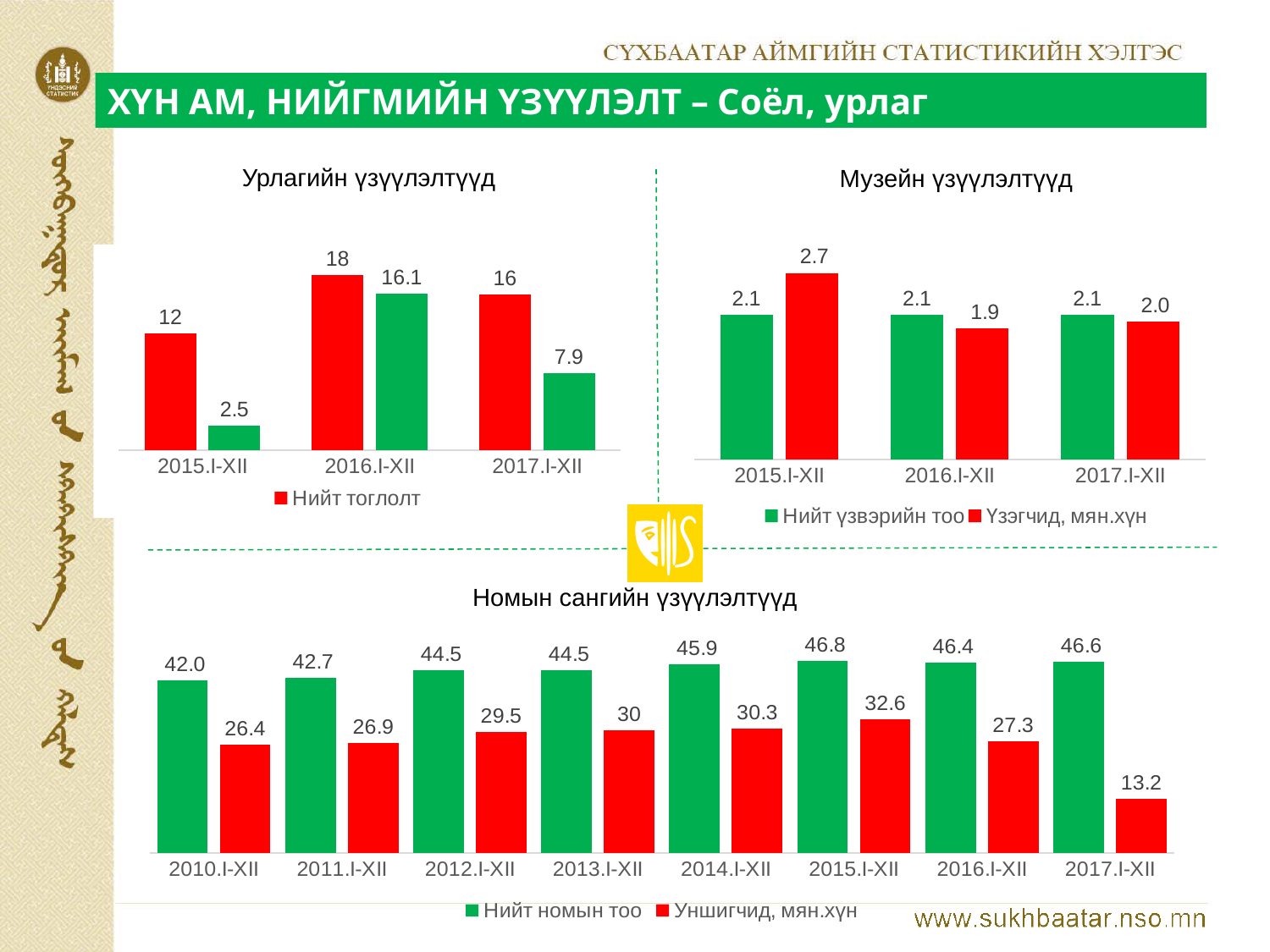
In the 'Номын сангийн үзүүлэлтүүд' chart, what is the value of 'Уншигчид, мян.хүн' for 2017.I-XII? 13.2 In the 'Музейн үзүүлэлтүүд' chart, which year has the lowest 'Үзэгчид, мян.хүн' value? 2016.I-XII What type of chart is the 'Номын сангийн үзүүлэлтүүд' chart? bar chart In the 'Номын сангийн үзүүлэлтүүд' chart, which year has the highest 'Уншигчид, мян.хүн' value? 2015.I-XII In the 'Урлагийн үзүүлэлтүүд' chart, what is the value of 'Нийт тоглолт' for 2016.I-XII? 18 In the 'Урлагийн үзүүлэлтүүд' chart, which year has the highest 'Нийт тоглолт' value? 2016.I-XII How many year categories are shown on the x axis of the 'Номын сангийн үзүүлэлтүүд' chart? 8 In the 'Музейн үзүүлэлтүүд' chart, what is the value of 'Үзэгчид, мян.хүн' for 2015.I-XII? 2.7 In the 'Урлагийн үзүүлэлтүүд' chart, what is the difference between the 'Нийт тоглолт' values for 2016.I-XII and 2015.I-XII? 6 In the 'Номын сангийн үзүүлэлтүүд' chart, is the 'Уншигчид, мян.хүн' value for 2013.I-XII larger or smaller than for 2016.I-XII? larger How many series does the legend of the 'Музейн үзүүлэлтүүд' chart list? 2 In the 'Номын сангийн үзүүлэлтүүд' chart, what is the value of 'Нийт номын тоо' for 2015.I-XII? 46.8